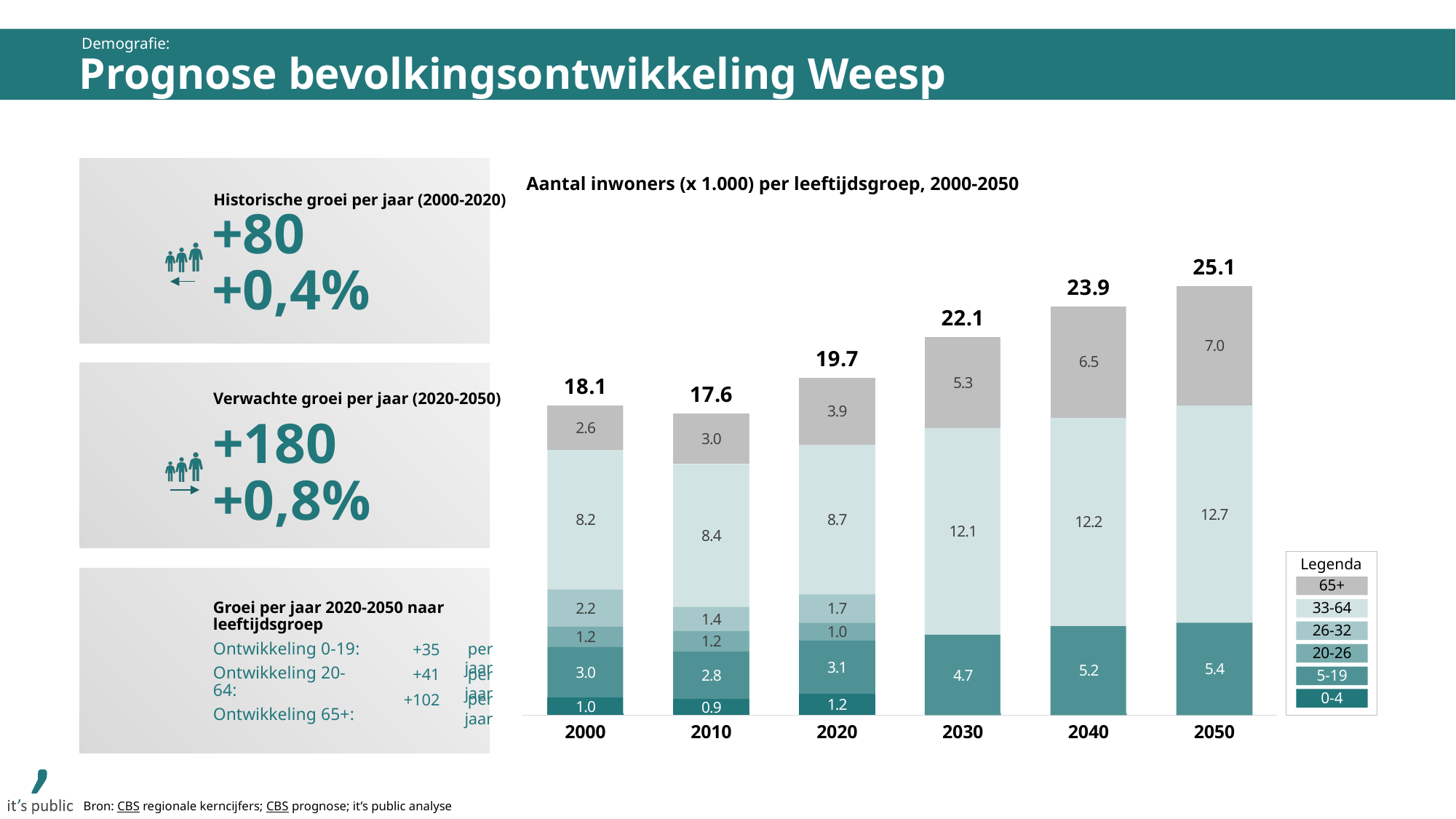
Which year has the lowest total number of inhabitants? 2010 Do the total values rise or fall from 2020 to 2050? Rise How many years are shown on the x axis of the chart? 6 How many age groups does the legend list? 6 What is the value of the 5-19 segment for 2000? 3.0 What is the difference between the total for 2050 and the total for 2000? 7.0 Which year has the highest total number of inhabitants? 2050 Which is larger: the 65+ segment in 2040 or the 65+ segment in 2030? 2040 What type of chart is shown on the slide? Stacked bar chart What is the total number of inhabitants (x 1.000) shown for 2050? 25.1 What is the value of the 65+ segment for 2020? 3.9 What is the value of the 33-64 segment for 2030? 12.1